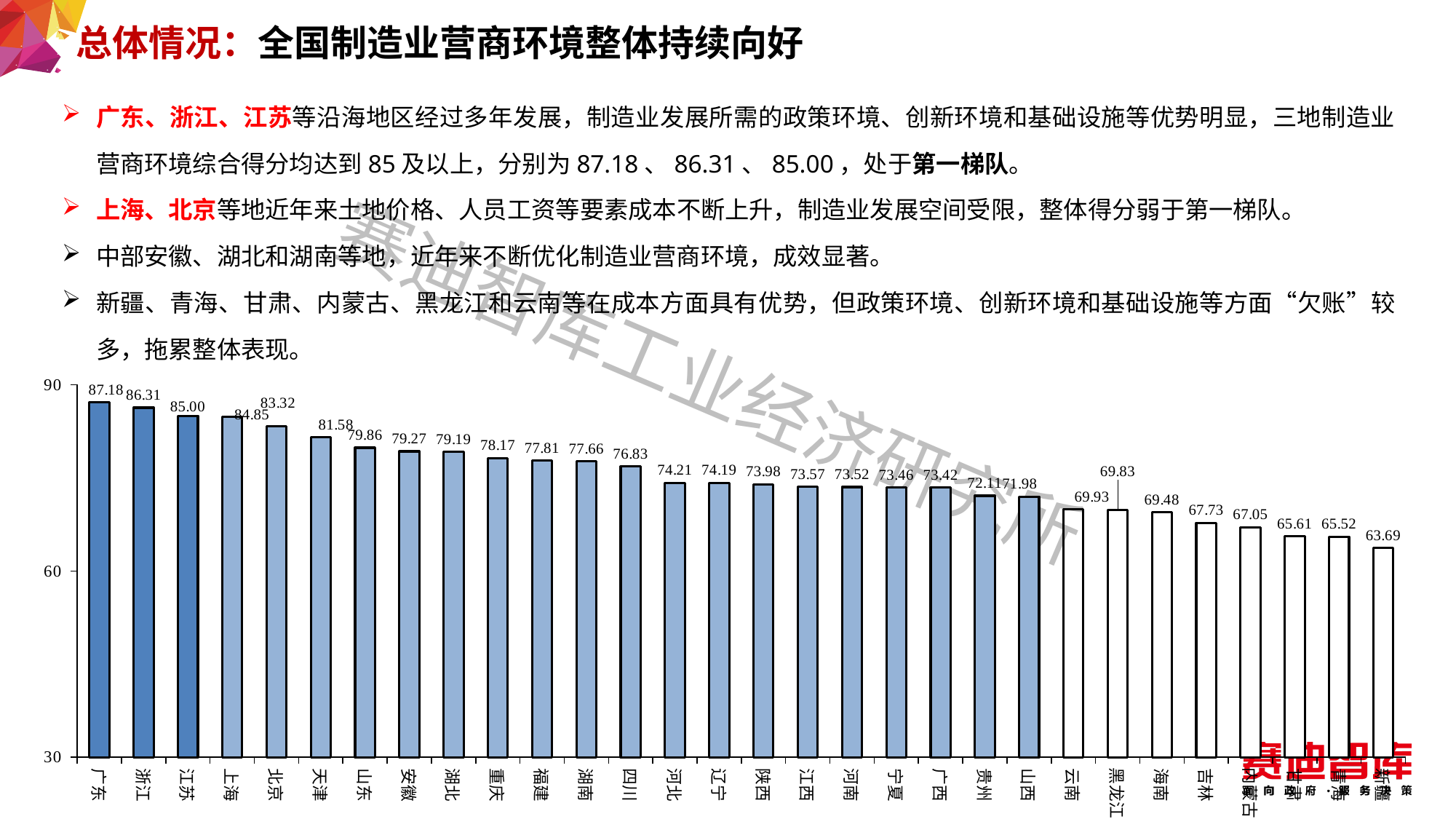
Do the values rise or fall from left to right along the x axis? fall Which province has the highest value? 广东 What is the value for 广东? 87.18 What type of chart is shown on the slide? bar chart How many provinces are shown in the chart? 30 What is the difference between the values for 广东 and 浙江? 0.87 What is the value for 安徽? 79.27 Which has a larger value, 山东 or 湖南? 山东 What is the difference between the values for 北京 and 天津? 1.74 What is the value for 上海? 84.85 Which province has the lowest value? 新疆 What is the value for 云南? 69.93